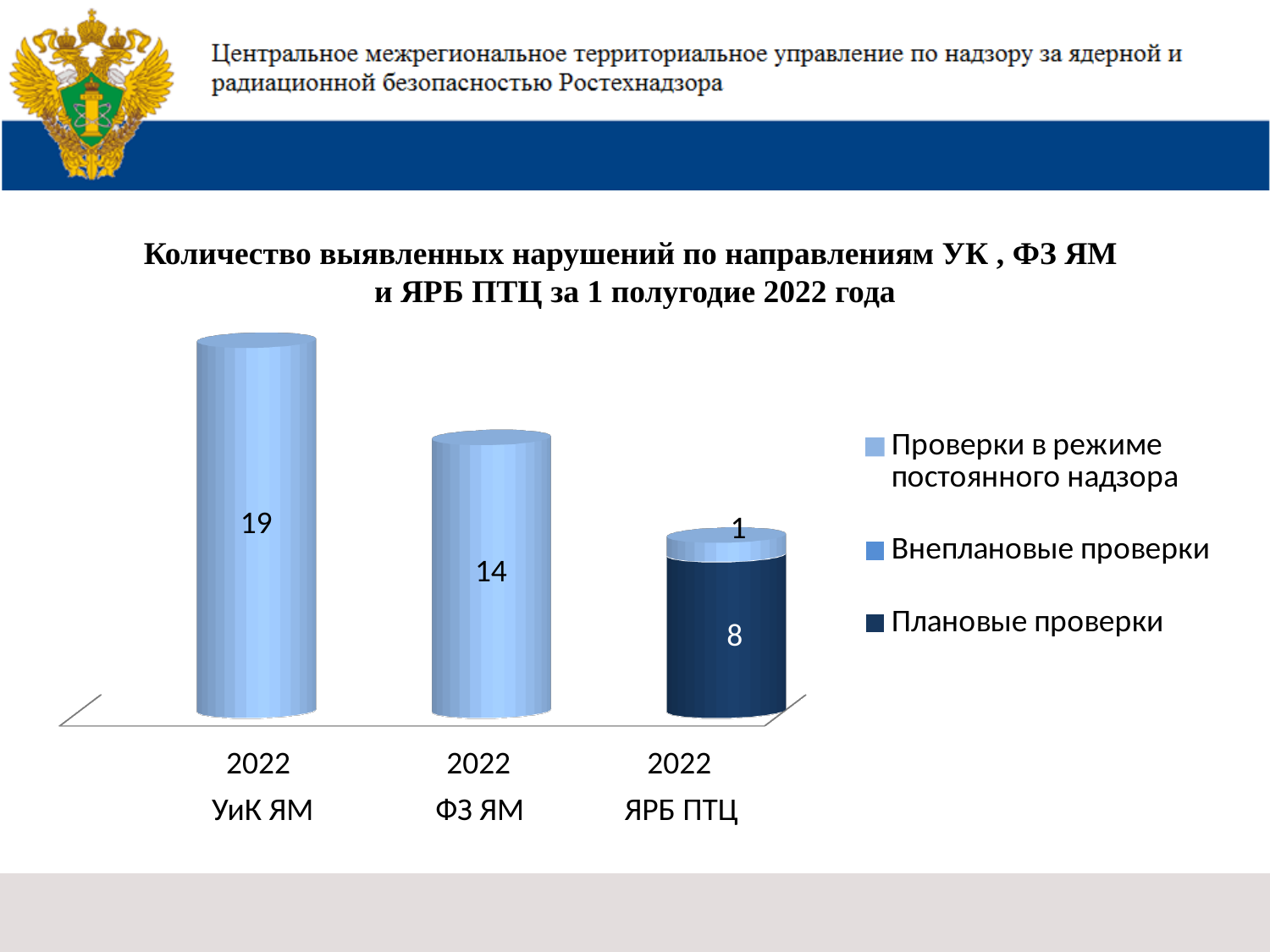
Which category has the lowest total? ЯРБ ПТЦ What is the value for ФЗ ЯМ? 14 How many categories are shown on the x axis? 3 What is the difference between the values for УиК ЯМ and ФЗ ЯМ? 5 What kind of chart is shown on the slide? Bar chart What is the value of Плановые проверки for ЯРБ ПТЦ? 8 Which is larger, the value for ФЗ ЯМ or the total for ЯРБ ПТЦ? ФЗ ЯМ How many series does the legend list? 3 Which category has the highest value? УиК ЯМ What is the value for УиК ЯМ? 19 What is the total of the stacked bar for ЯРБ ПТЦ? 9